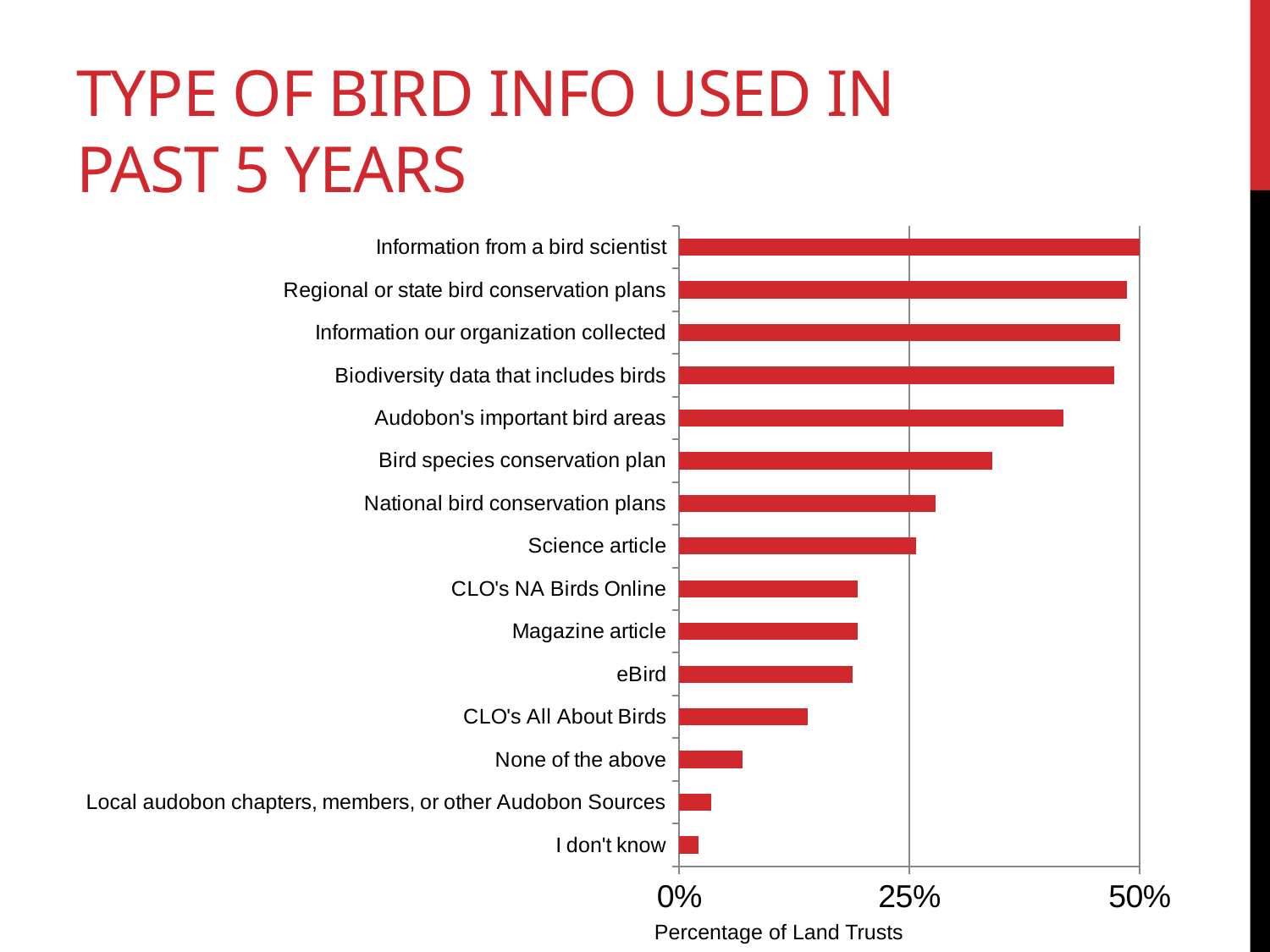
What is the label of the horizontal axis? Percentage of Land Trusts Which is larger, the value for CLO's All About Birds or the value for eBird? eBird Which is larger, the value for Bird species conservation plan or the value for Science article? Bird species conservation plan Is the value for Audobon's important bird areas greater or less than 25%? greater Is the value for Regional or state bird conservation plans greater or less than 25%? greater Is the value for CLO's NA Birds Online greater or less than 25%? less How many categories are plotted in the chart? 15 Which category has the lowest percentage of land trusts? I don't know What is the title of the slide containing the chart? TYPE OF BIRD INFO USED IN PAST 5 YEARS What kind of chart is shown on the slide? bar chart Which category has the highest percentage of land trusts? Information from a bird scientist